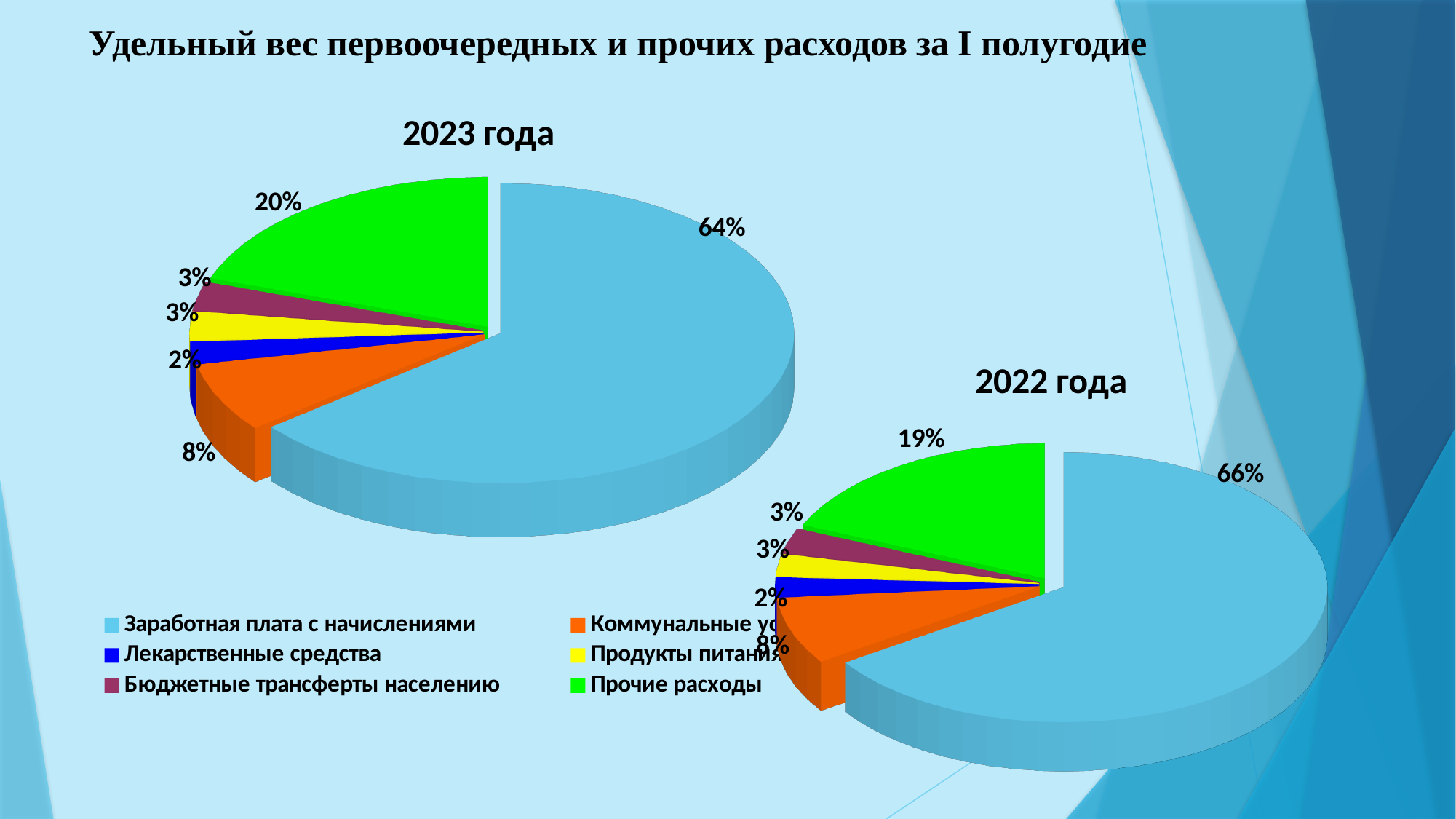
What is the difference between the share of Заработная плата с начислениями in the 2022 года chart and in the 2023 года chart? 2% In the 2023 года pie chart, what share is shown for Заработная плата с начислениями? 64% In the 2022 года pie chart, what share is shown for Прочие расходы? 19% In the 2022 года pie chart, what share is shown for Продукты питания? 3% How many categories does the legend list? 6 Which is larger: the share of Прочие расходы in the 2023 года chart or in the 2022 года chart? 2023 года In the 2023 года pie chart, what share is shown for Лекарственные средства? 2% In the 2022 года pie chart, which category has the smallest share? Лекарственные средства In the 2022 года pie chart, what share is shown for Заработная плата с начислениями? 66% In the 2023 года pie chart, which category has the largest share? Заработная плата с начислениями What type of chart is used for 2023 года? Pie chart In the 2023 года pie chart, what share is shown for Прочие расходы? 20%